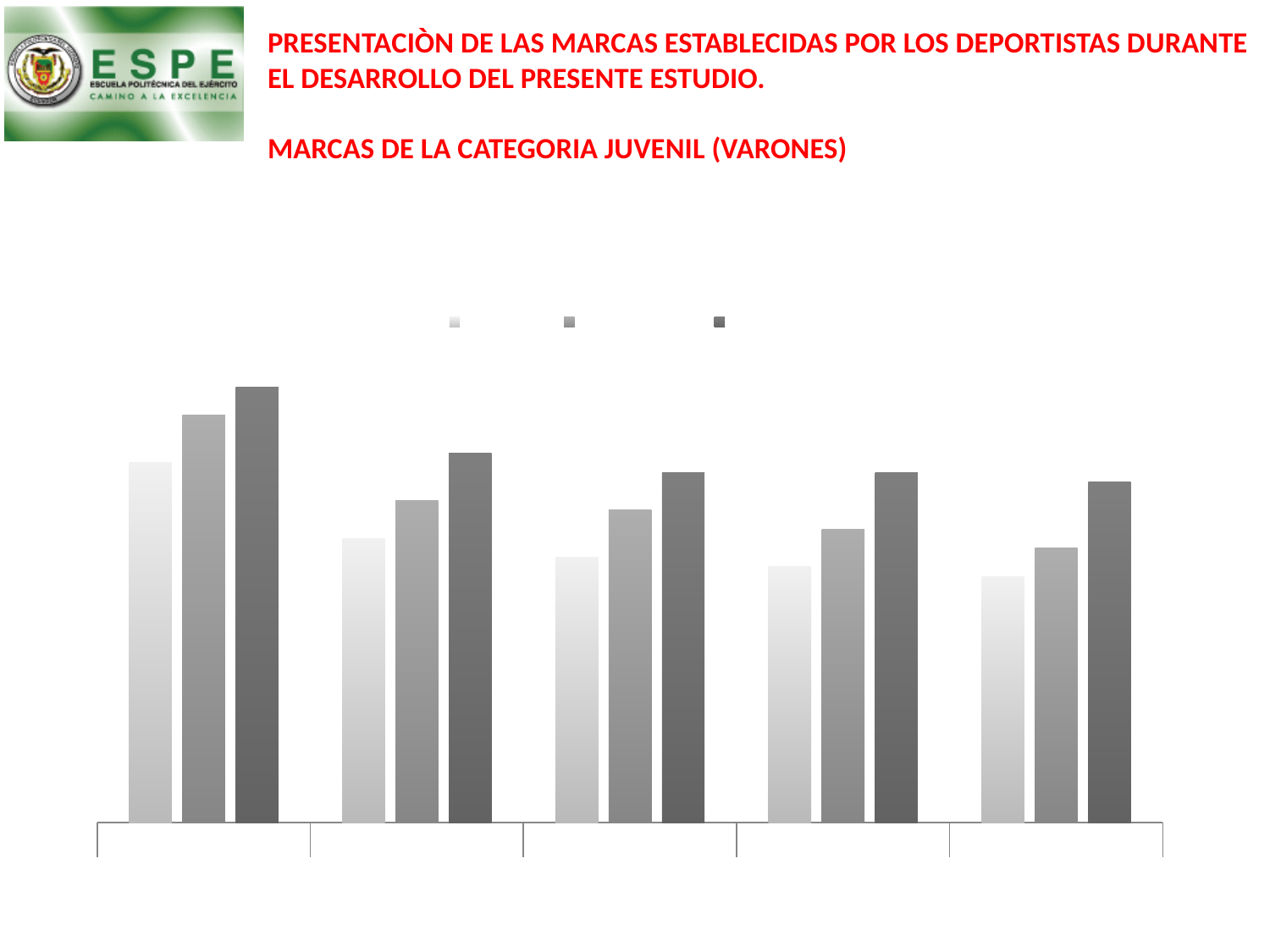
How many groups of bars (categories) are plotted along the x axis? 5 Which group of bars, counted from the left, contains the tallest bar on the chart? the first (leftmost) group How many bars are plotted in total on the chart? 15 How many series does the legend list? 3 Within the leftmost group, do the three bars rise or fall from left to right? rise In the leftmost group, which is taller: the lightest bar or the darkest bar? the darkest bar Which series, by shade, has the shortest bar in every group? the lightest grey series Comparing the lightest bars of the first and second groups from the left, which is taller? the first group Which series, by shade, has the tallest bar in every group? the darkest grey series What kind of chart is shown on the slide? bar chart